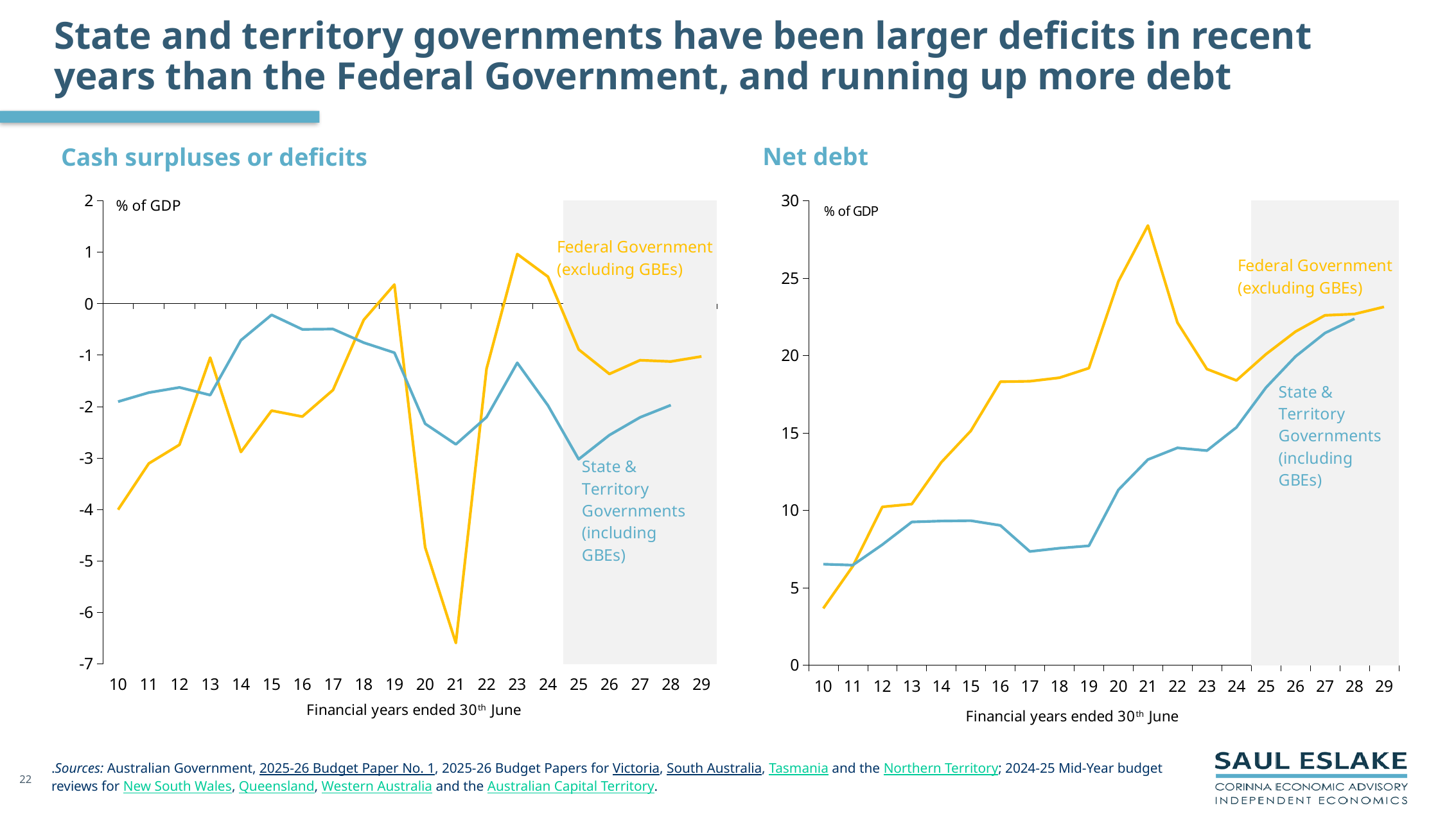
On the 'Net debt' chart, does the State & Territory Governments (including GBEs) line generally rise or fall from 19 to 28? rise On the 'Cash surpluses or deficits' chart, in which financial year does the Federal Government (excluding GBEs) line reach its highest value? 23 On the 'Net debt' chart, which series has the higher value in financial year 21, Federal Government (excluding GBEs) or State & Territory Governments (including GBEs)? Federal Government (excluding GBEs) On the 'Net debt' chart, in which financial year does the Federal Government (excluding GBEs) line peak? 21 How many financial years are shown on the x axis of the 'Cash surpluses or deficits' chart? 20 On the 'Net debt' chart, is the State & Territory Governments (including GBEs) value for 17 greater or less than 10? less On the 'Net debt' chart, is the Federal Government (excluding GBEs) value for 21 greater or less than 25? greater On the 'Cash surpluses or deficits' chart, in which financial year does the Federal Government (excluding GBEs) line reach its lowest value? 21 How many series are plotted on the 'Net debt' chart? 2 On the 'Cash surpluses or deficits' chart, is the Federal Government (excluding GBEs) value for 21 greater or less than -6? less What kind of chart is the 'Cash surpluses or deficits' chart? line chart